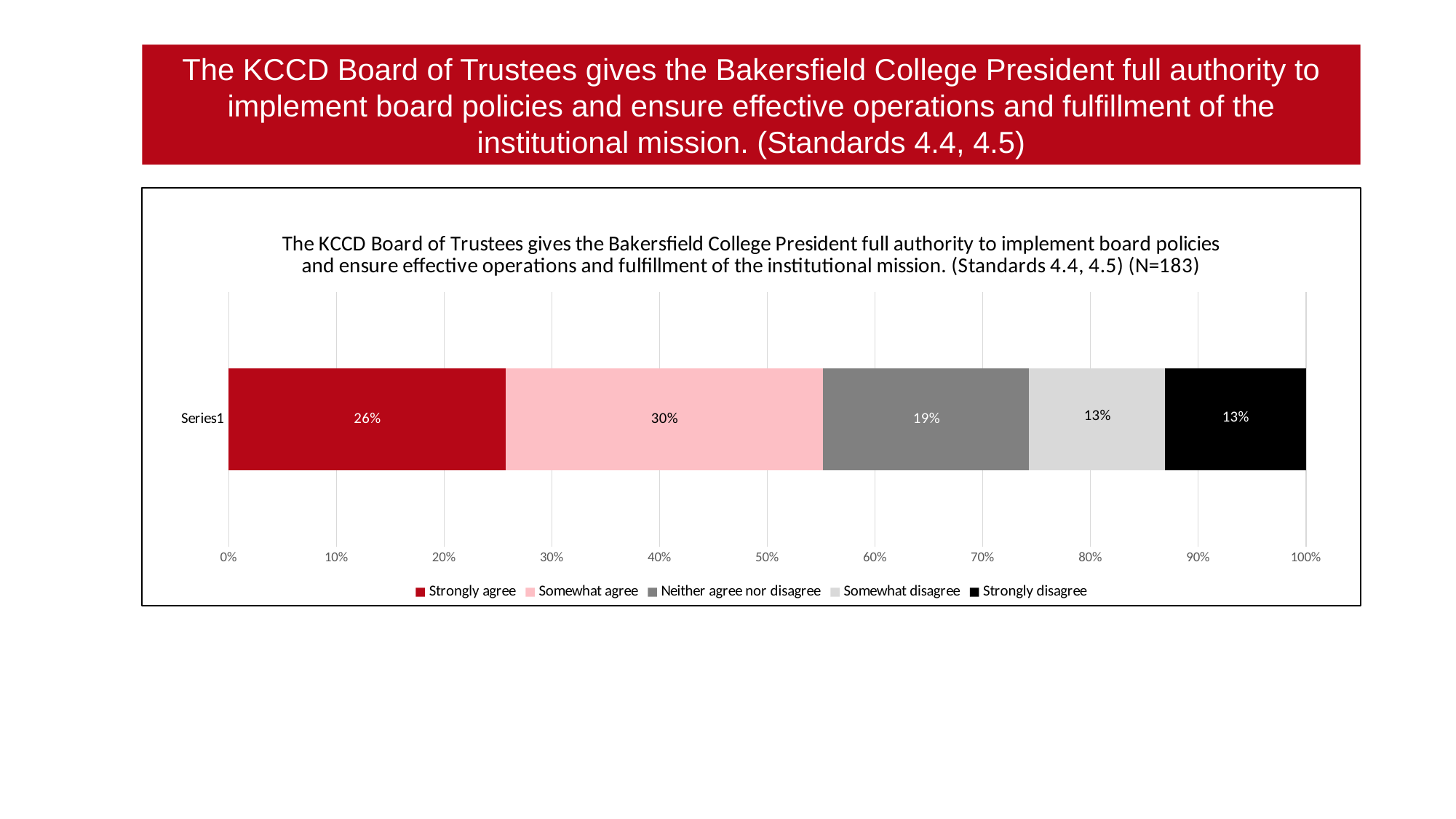
What kind of chart is shown on the slide? Stacked bar chart What is the combined percentage for Strongly agree and Somewhat agree? 56% Which response category has the highest percentage? Somewhat agree What percentage of respondents selected Neither agree nor disagree? 19% What is the sample size (N) stated in the chart title? 183 How many response categories does the legend list? 5 What percentage of respondents selected Strongly agree? 26% What percentage of respondents selected Strongly disagree? 13% Which colour represents Strongly disagree in the chart? Black What is the difference in percentage points between Somewhat agree and Strongly agree? 4 What percentage of respondents selected Somewhat agree? 30% Which is larger, the share for Strongly agree or the share for Neither agree nor disagree? Strongly agree